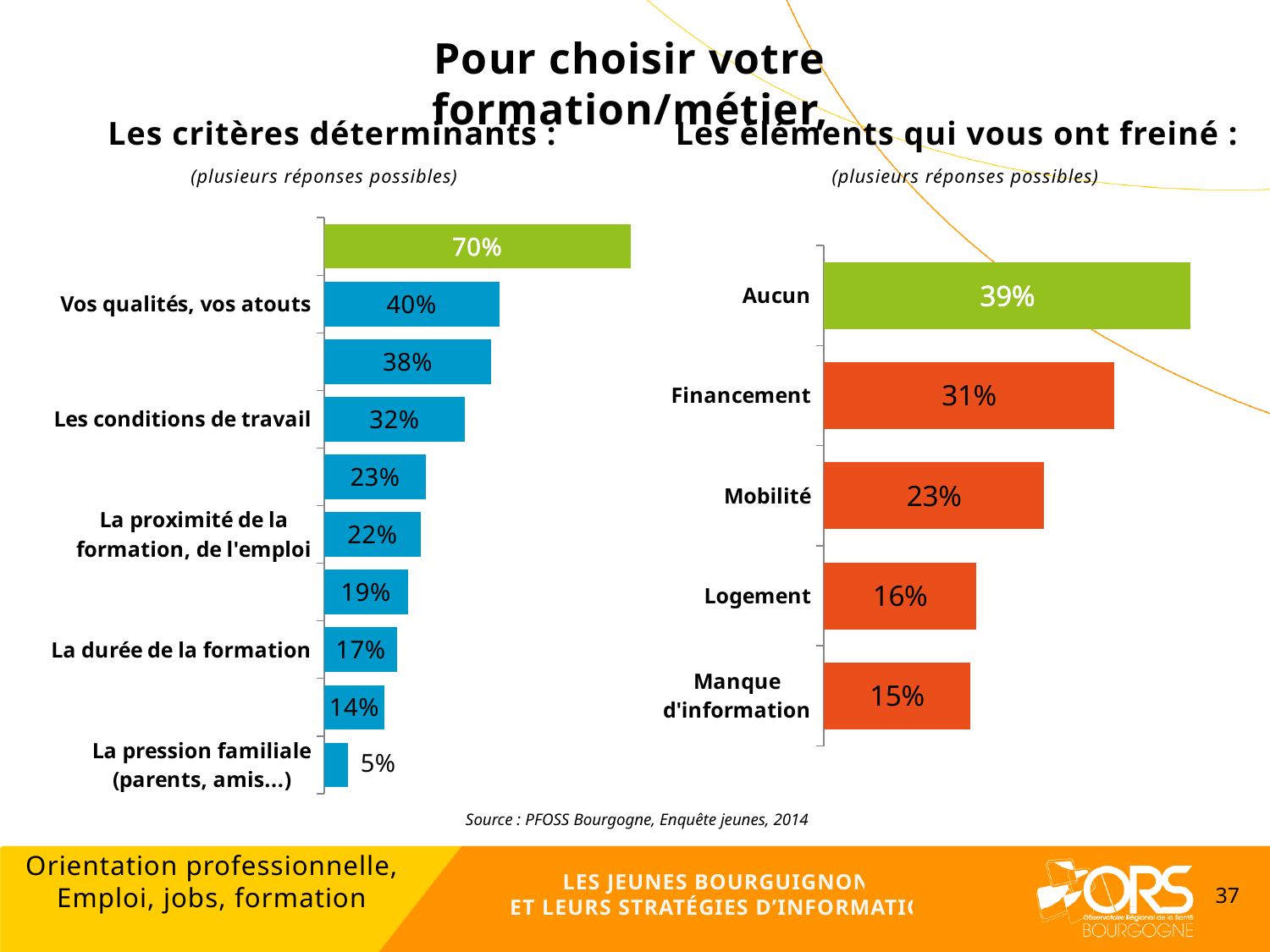
What type of chart is used for 'Les éléments qui vous ont freiné'? Bar chart In the chart 'Les éléments qui vous ont freiné', what is the value for Financement? 31% In the chart 'Les critères déterminants', what is the value for 'La pression familiale (parents, amis...)'? 5% In the chart 'Les éléments qui vous ont freiné', which category has the lowest value? Manque d'information In the chart 'Les éléments qui vous ont freiné', what is the value for Manque d'information? 15% In the chart 'Les critères déterminants', what is the value for 'La durée de la formation'? 17% In the chart 'Les critères déterminants', what is the difference between 'Vos qualités, vos atouts' and 'Les conditions de travail'? 8% In the chart 'Les éléments qui vous ont freiné', how many categories are shown? 5 In the chart 'Les critères déterminants', what is the value for 'Vos qualités, vos atouts'? 40% In the chart 'Les critères déterminants', which is larger: 'Les conditions de travail' or 'La proximité de la formation, de l'emploi'? Les conditions de travail In the chart 'Les éléments qui vous ont freiné', what is the difference between Aucun and Mobilité? 16% In the chart 'Les éléments qui vous ont freiné', which category has the highest value? Aucun